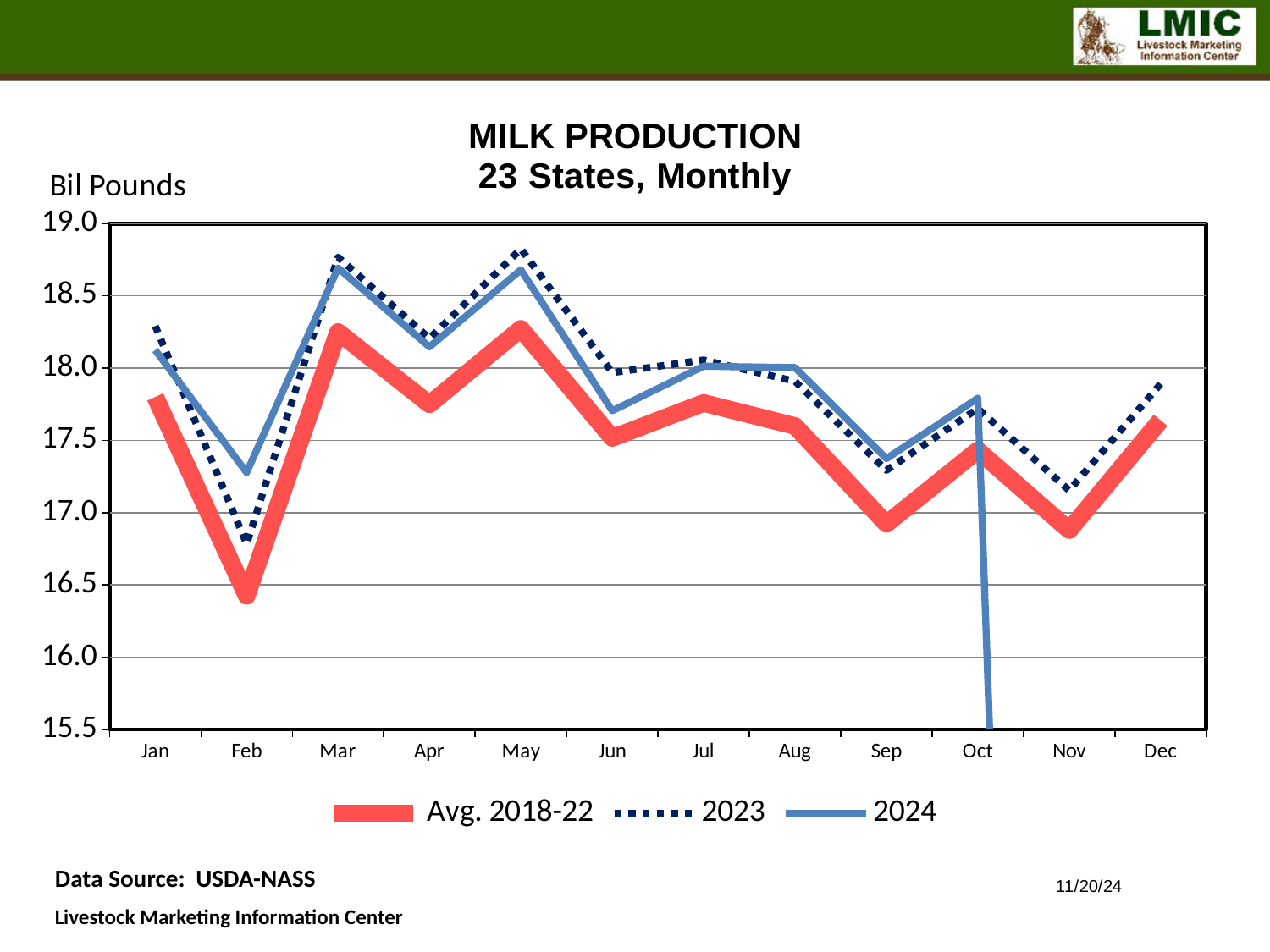
Which month has the lowest value for the Avg. 2018-22 series? Feb What unit label is shown above the y axis? Bil Pounds In Mar, which is larger: the 2023 value or the Avg. 2018-22 value? 2023 Is the value for the Avg. 2018-22 series in Sep greater or less than 17.5? less How many series does the legend list? 3 Is the value for the 2024 series in Mar greater or less than 18.5? greater Does the Avg. 2018-22 series rise or fall from Jan to Feb? Fall How many months are shown along the x axis? 12 What kind of chart is shown on the slide? Line chart Is the value for the 2023 series in Nov greater or less than 17.5? less Which month has the lowest value for the 2023 series? Feb